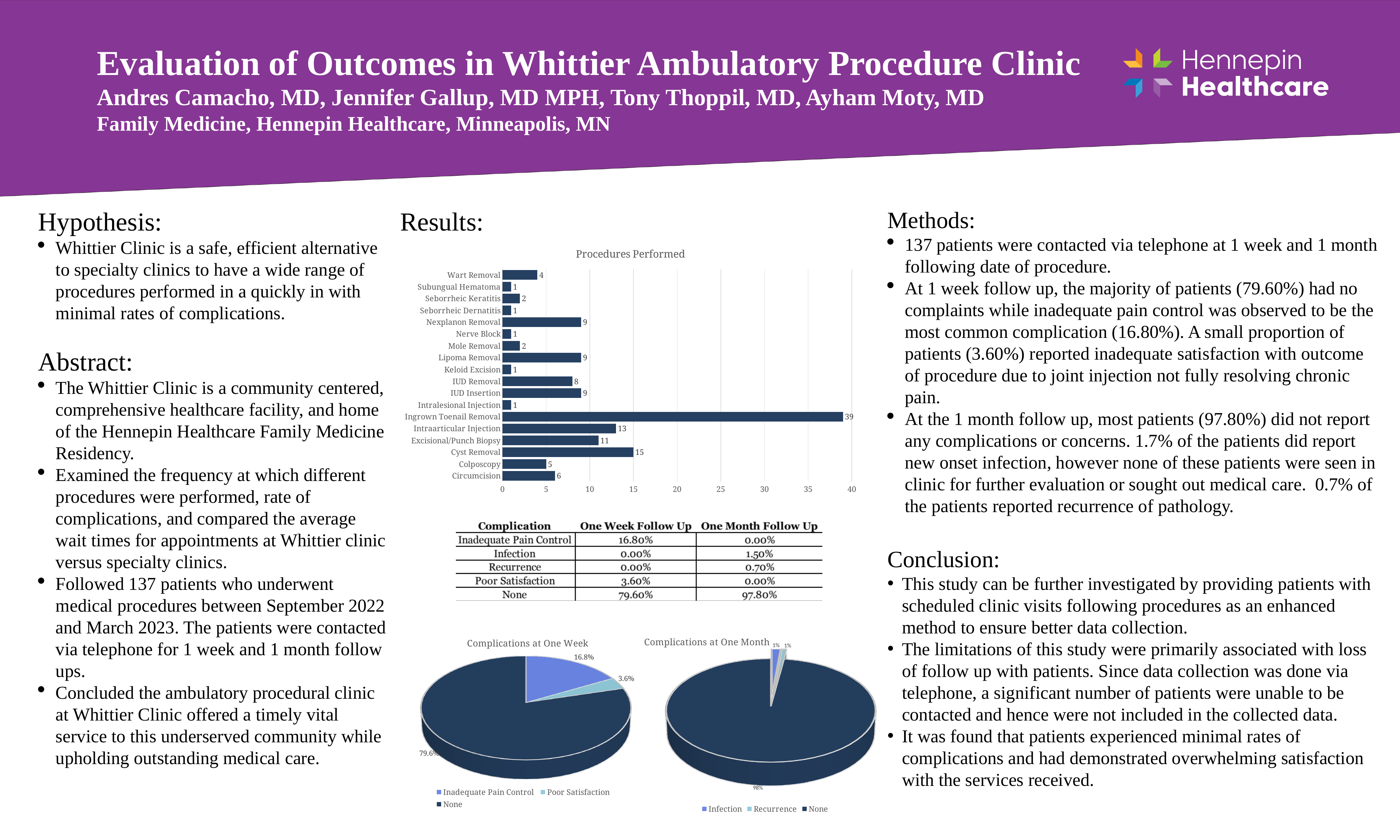
In the Complications at One Week pie chart, which slice is the largest? None In the Procedures Performed chart, what is the difference between Intraarticular Injection and Excisional/Punch Biopsy? 2 What kind of chart is the Procedures Performed chart? Bar chart In the Complications at One Week pie chart, what share is Inadequate Pain Control? 16.8% In the Procedures Performed chart, which procedure has the highest count? Ingrown Toenail Removal In the Complications at One Month pie chart, what share is None? 98% In the Procedures Performed chart, how many Ingrown Toenail Removal procedures were performed? 39 How many procedure categories are shown in the Procedures Performed chart? 18 In the Procedures Performed chart, which is larger, IUD Removal or IUD Insertion? IUD Insertion How many entries does the legend of the Complications at One Month pie chart list? 3 In the Procedures Performed chart, what is the value for Cyst Removal? 15 In the Complications at One Week pie chart, what share is Poor Satisfaction? 3.6%